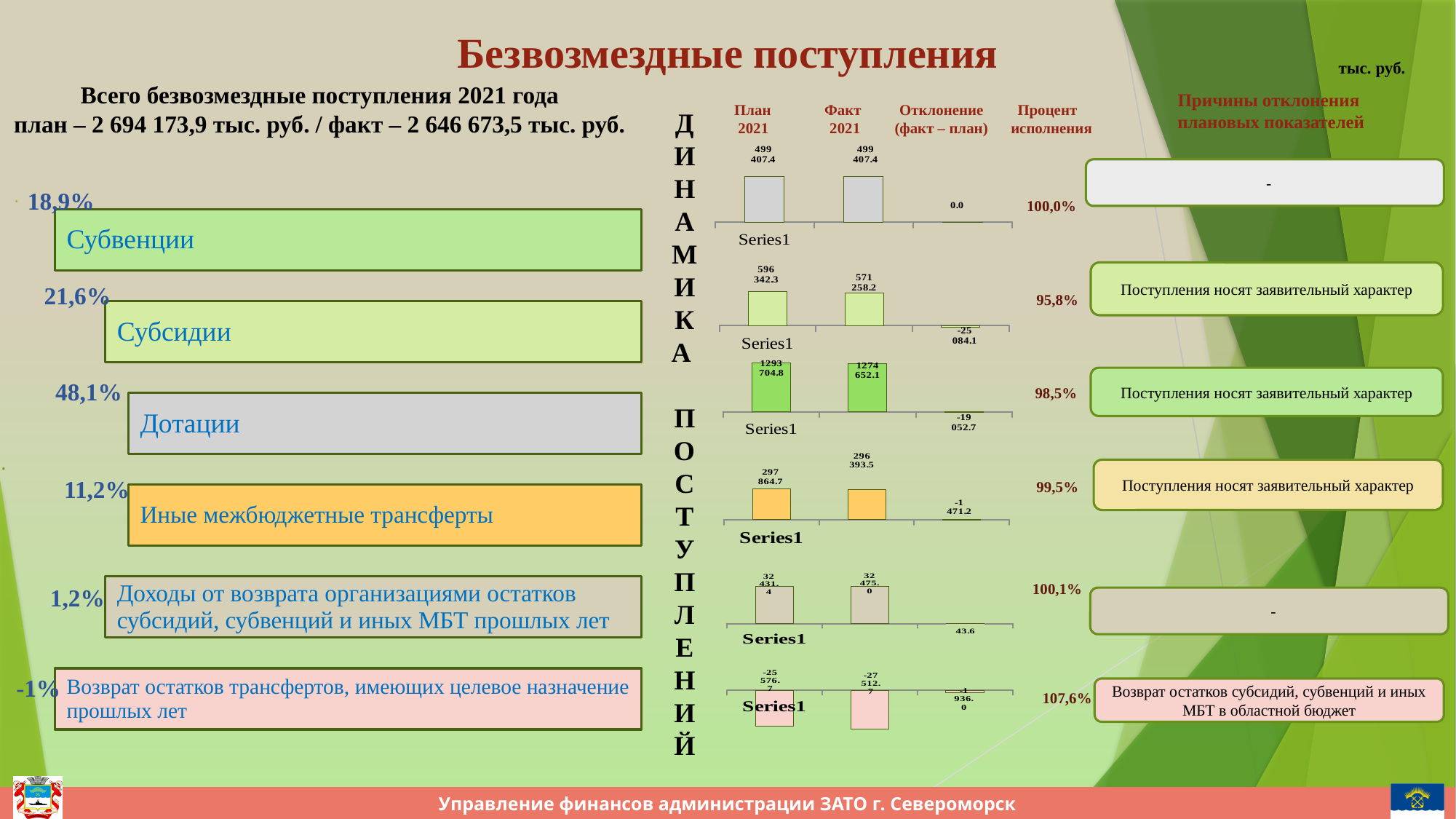
In the chart in the Дотации row, what is the difference between План 2021 and Факт 2021? 19 052.7 In the chart in the Возврат остатков трансфертов row, what is the value of План 2021? -25 576.7 In the chart in the Субсидии row, what is the value of Факт 2021? 571 258.2 In the chart in the Дотации row, what is the value of Отклонение (факт – план)? -19 052.7 What kind of chart is used in the Субвенции row? Bar chart What label appears on the x axis of the chart in the Дотации row? Series1 In the chart in the Иные межбюджетные трансферты row, what is the value of Факт 2021? 296 393.5 How many bars does the chart in the Иные межбюджетные трансферты row have? 3 In the chart in the Доходы от возврата организациями остатков row, what is the value of Отклонение (факт – план)? 43.6 In the chart in the Субсидии row, which is larger, План 2021 or Факт 2021? План 2021 In the chart in the Субвенции row, what is the value of Отклонение (факт – план)? 0.0 In the chart in the Субвенции row, what is the value of План 2021? 499 407.4